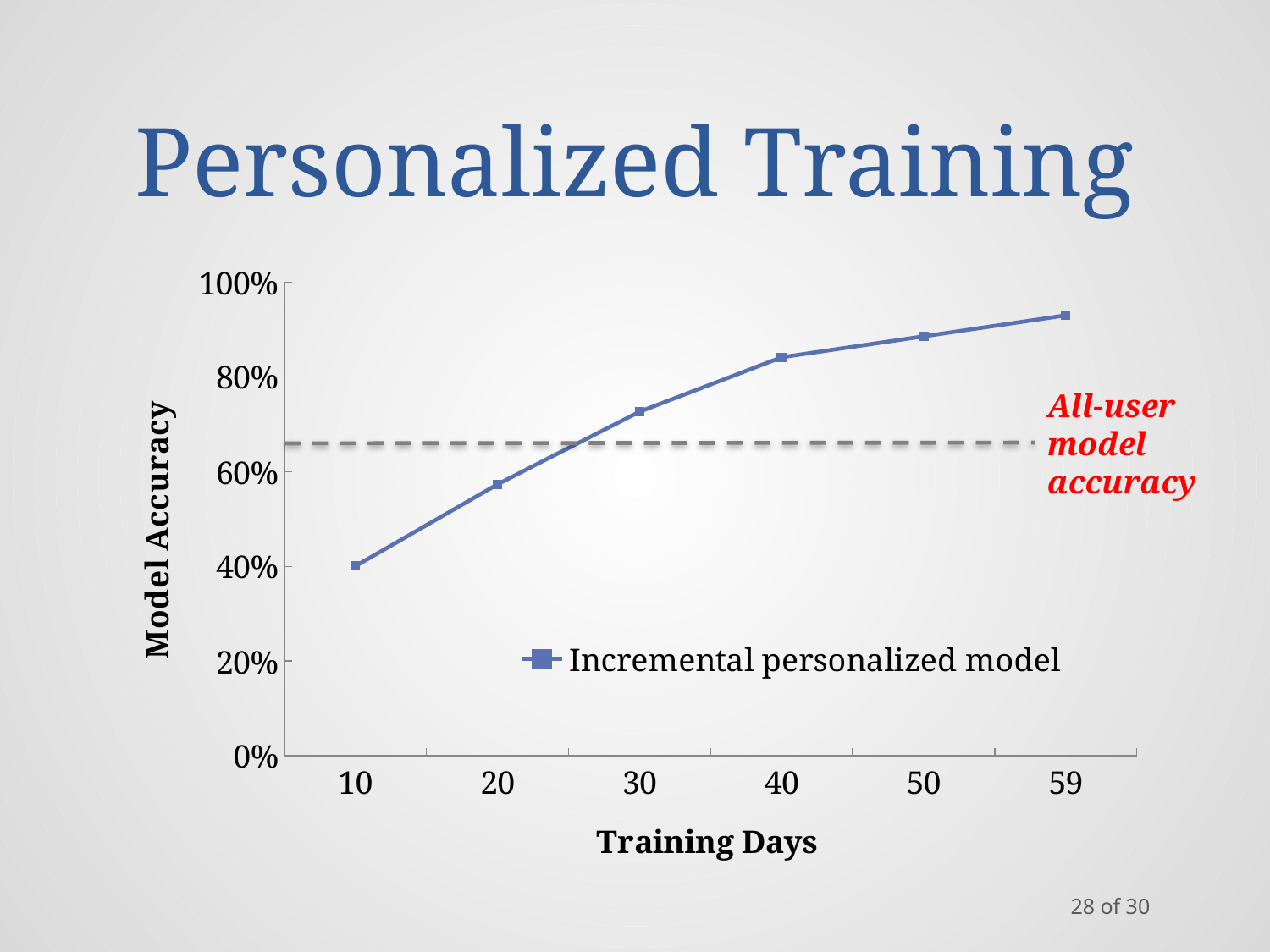
Is the model accuracy at 20 training days greater or less than 60%? less What kind of chart is shown on the slide? line chart Which has the higher model accuracy: 30 training days or 50 training days? 50 training days What is the title of the y axis? Model Accuracy Is the model accuracy at 30 training days greater or less than 60%? greater What does the dashed horizontal line represent? All-user model accuracy Does model accuracy rise or fall as training days increase along the x axis? rise Is the model accuracy at 40 training days greater or less than 80%? greater How many series does the legend list? 1 At which number of training days is the Incremental personalized model accuracy lowest? 10 How many data points are plotted for the Incremental personalized model series? 6 At which number of training days is the Incremental personalized model accuracy highest? 59